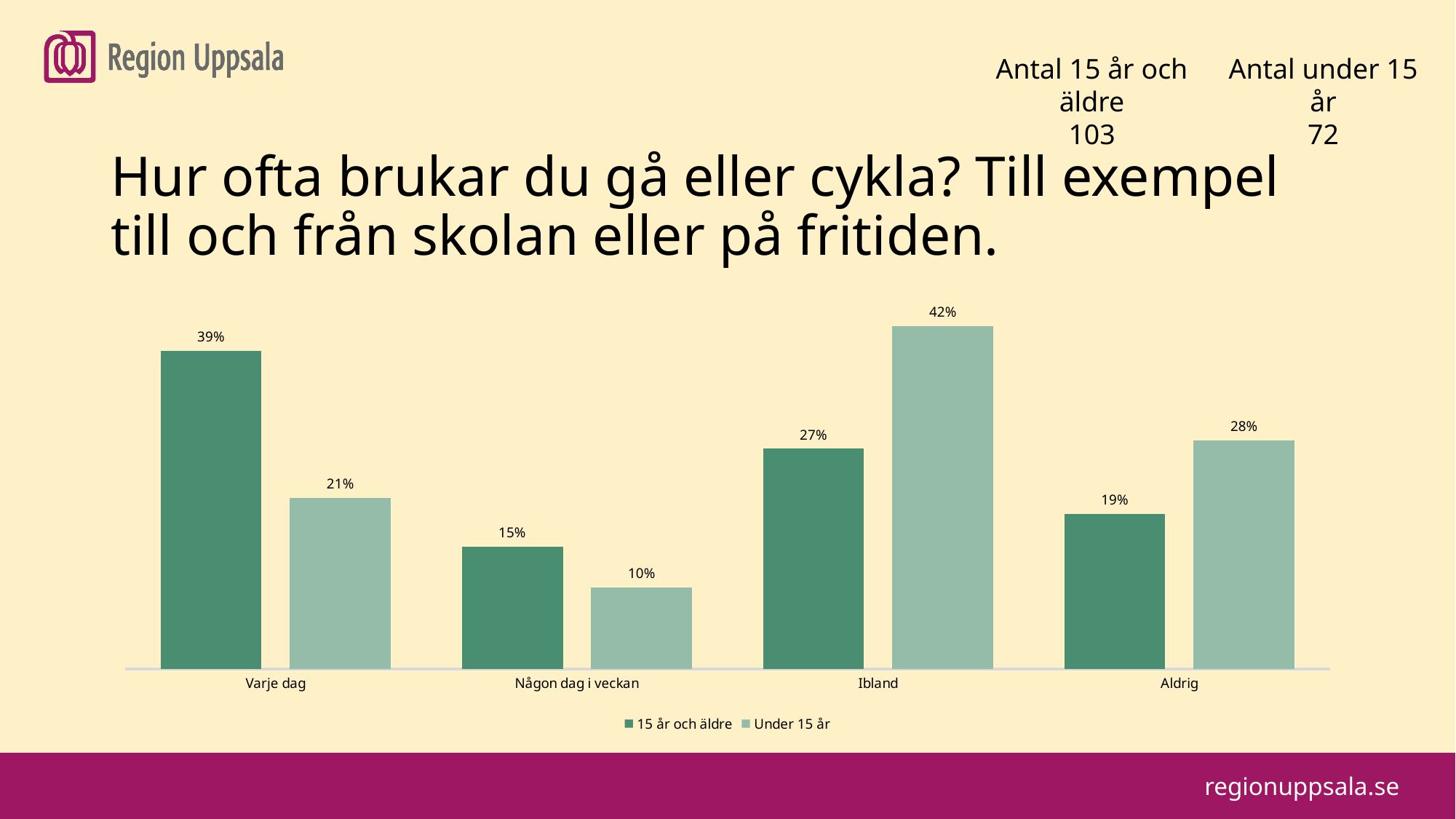
Which category has the lowest value in the "Under 15 år" series? Någon dag i veckan How many series does the legend list? 2 Which series is shown in the darker green colour? 15 år och äldre How many categories are shown on the x axis? 4 What is the value for "Ibland" in the "Under 15 år" series? 42% Which series has the larger value for "Aldrig"? Under 15 år What is the difference between the "Under 15 år" and "15 år och äldre" values for "Ibland"? 15% What is the difference between the "15 år och äldre" and "Under 15 år" values for "Varje dag"? 18% What kind of chart is shown on the slide? Bar chart What is the value for "Någon dag i veckan" in the "Under 15 år" series? 10% What is the value for "Varje dag" in the "15 år och äldre" series? 39% Which category has the highest value in the "15 år och äldre" series? Varje dag